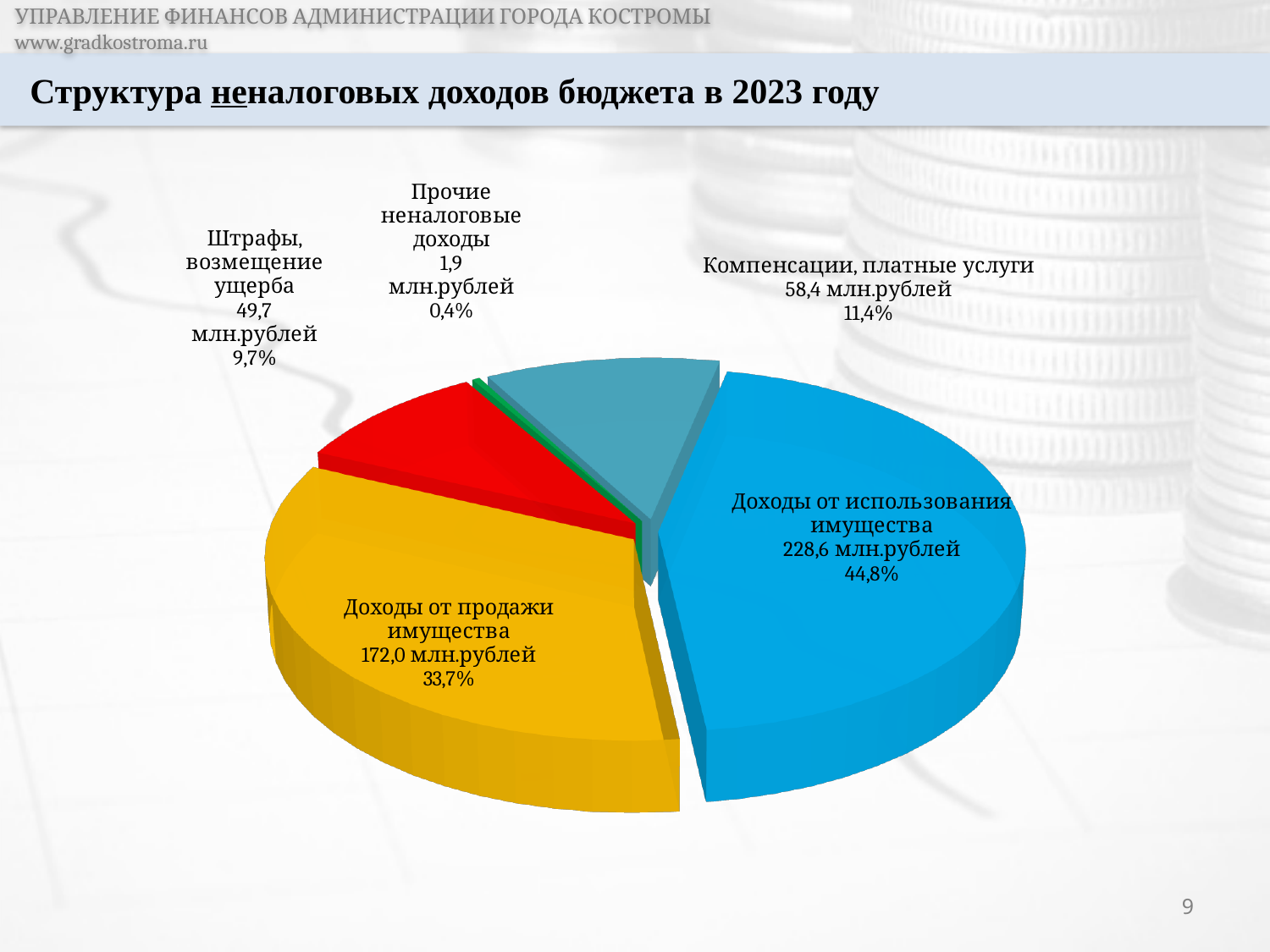
Which category has the smallest share of the pie? Прочие неналоговые доходы What is the difference in млн.рублей between «Доходы от использования имущества» and «Доходы от продажи имущества»? 56,6 млн.рублей What share of the pie does «Доходы от продажи имущества» represent? 33,7% What is the title of the chart on the slide? Структура неналоговых доходов бюджета в 2023 году What is the value for «Прочие неналоговые доходы»? 1,9 млн.рублей How many slices does the pie chart have? 5 What kind of chart is shown on the slide? Pie chart Which category has the largest share of the pie? Доходы от использования имущества What is the value for «Компенсации, платные услуги»? 58,4 млн.рублей What share of the pie does «Штрафы, возмещение ущерба» represent? 9,7% Which is larger: «Компенсации, платные услуги» or «Штрафы, возмещение ущерба»? Компенсации, платные услуги What is the value for «Доходы от использования имущества»? 228,6 млн.рублей